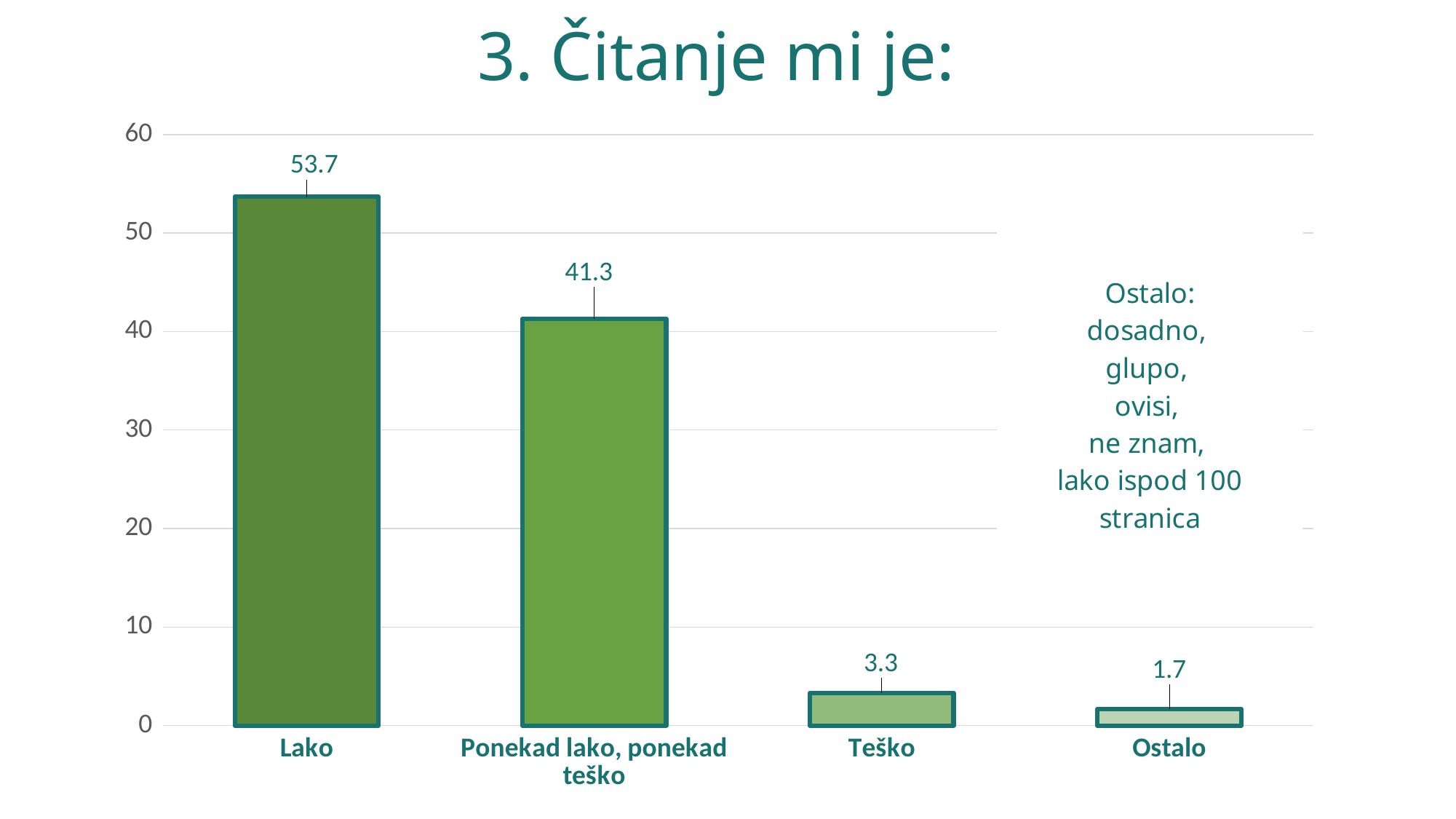
Which category has the lowest value? Ostalo What kind of chart is shown on the slide? bar chart What is the value for Ostalo? 1.7 What is the value for Lako? 53.7 How many categories are shown in the chart? 4 What is the title of the slide? 3. Čitanje mi je: What is the value for Ponekad lako, ponekad teško? 41.3 Is the value for Ponekad lako, ponekad teško greater or less than 40? greater What is the value for Teško? 3.3 Which category has the highest value? Lako What is the difference between the values for Lako and Ponekad lako, ponekad teško? 12.4 Which is larger, the value for Teško or the value for Ostalo? Teško